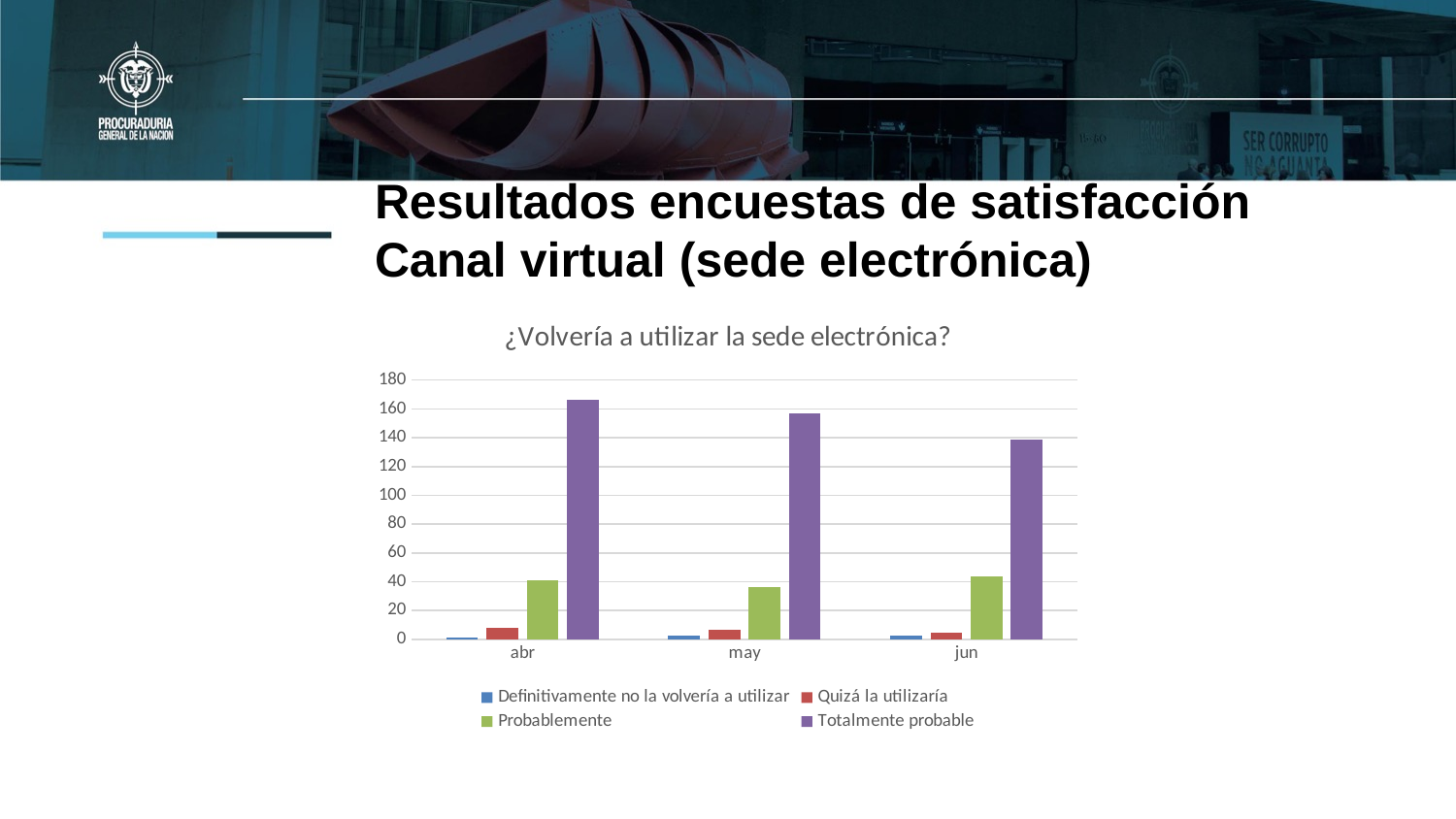
What is the title of the chart? ¿Volvería a utilizar la sede electrónica? Which is larger, the value for Probablemente in abr or in may? abr Is the value for Totalmente probable in jun greater or less than 160? less How many series does the legend list? 4 Is the value for Probablemente in abr greater or less than 60? less How many months are shown on the x axis? 3 Which response series has the highest value in abr? Totalmente probable Which response series has the lowest value in may? Definitivamente no la volvería a utilizar What kind of chart is shown on the slide? bar chart Is the value for Totalmente probable in abr greater or less than 140? greater Which is larger, the value for Totalmente probable in may or in jun? may Does the value for Totalmente probable rise or fall from abr to jun? fall